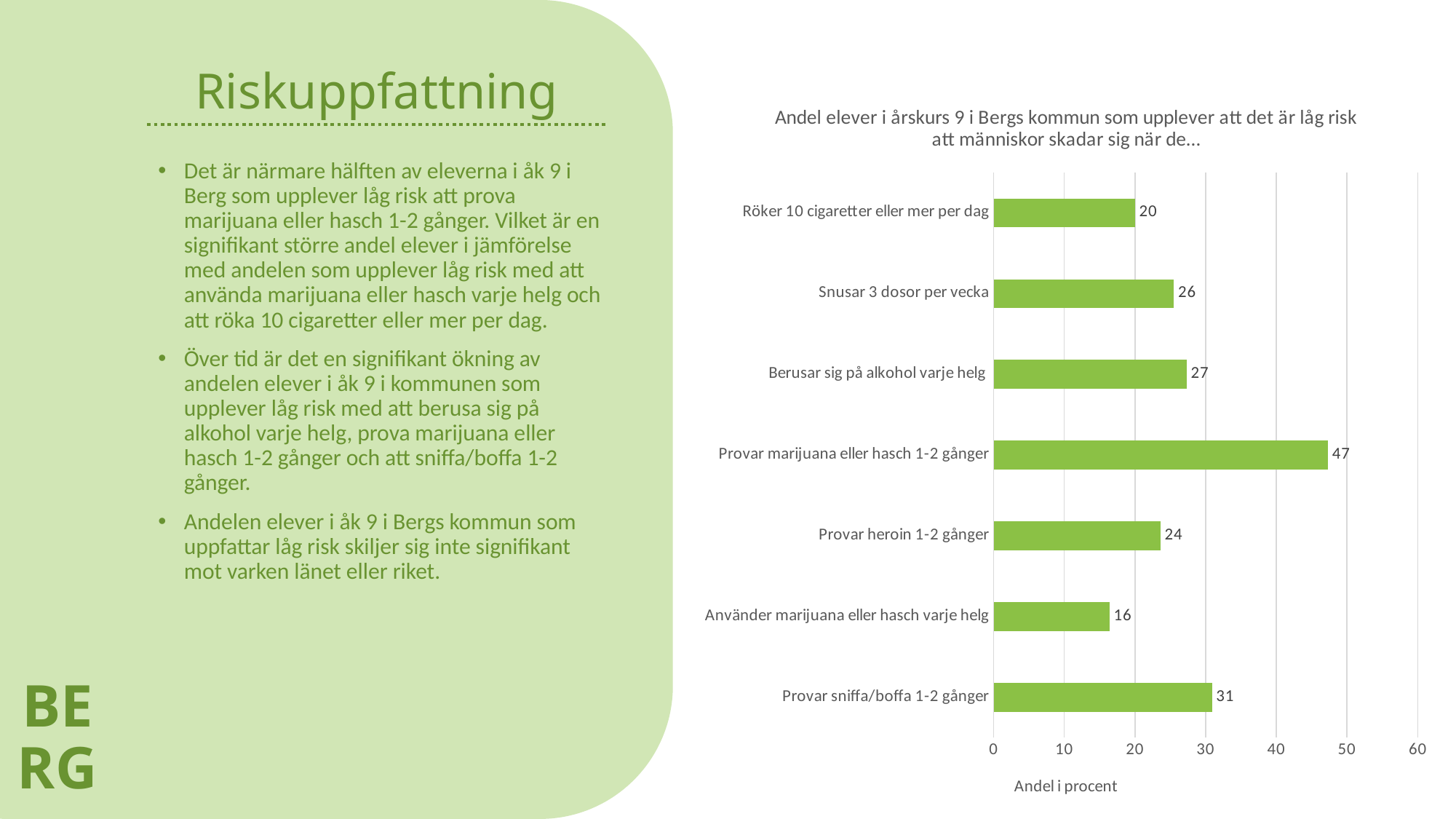
What is the value for "Provar marijuana eller hasch 1-2 gånger"? 47 What is the value for "Provar heroin 1-2 gånger"? 24 Which is larger: the value for "Snusar 3 dosor per vecka" or the value for "Provar sniffa/boffa 1-2 gånger"? Provar sniffa/boffa 1-2 gånger Which category has the highest value? Provar marijuana eller hasch 1-2 gånger How many categories are shown in the chart? 7 Is the value for "Berusar sig på alkohol varje helg" greater or less than 20? greater What is the difference between the values for "Provar marijuana eller hasch 1-2 gånger" and "Använder marijuana eller hasch varje helg"? 31 What is the label of the horizontal axis of the chart? Andel i procent What is the value for "Provar sniffa/boffa 1-2 gånger"? 31 What kind of chart is shown on the slide? bar chart What is the value for "Röker 10 cigaretter eller mer per dag"? 20 Which category has the lowest value? Använder marijuana eller hasch varje helg